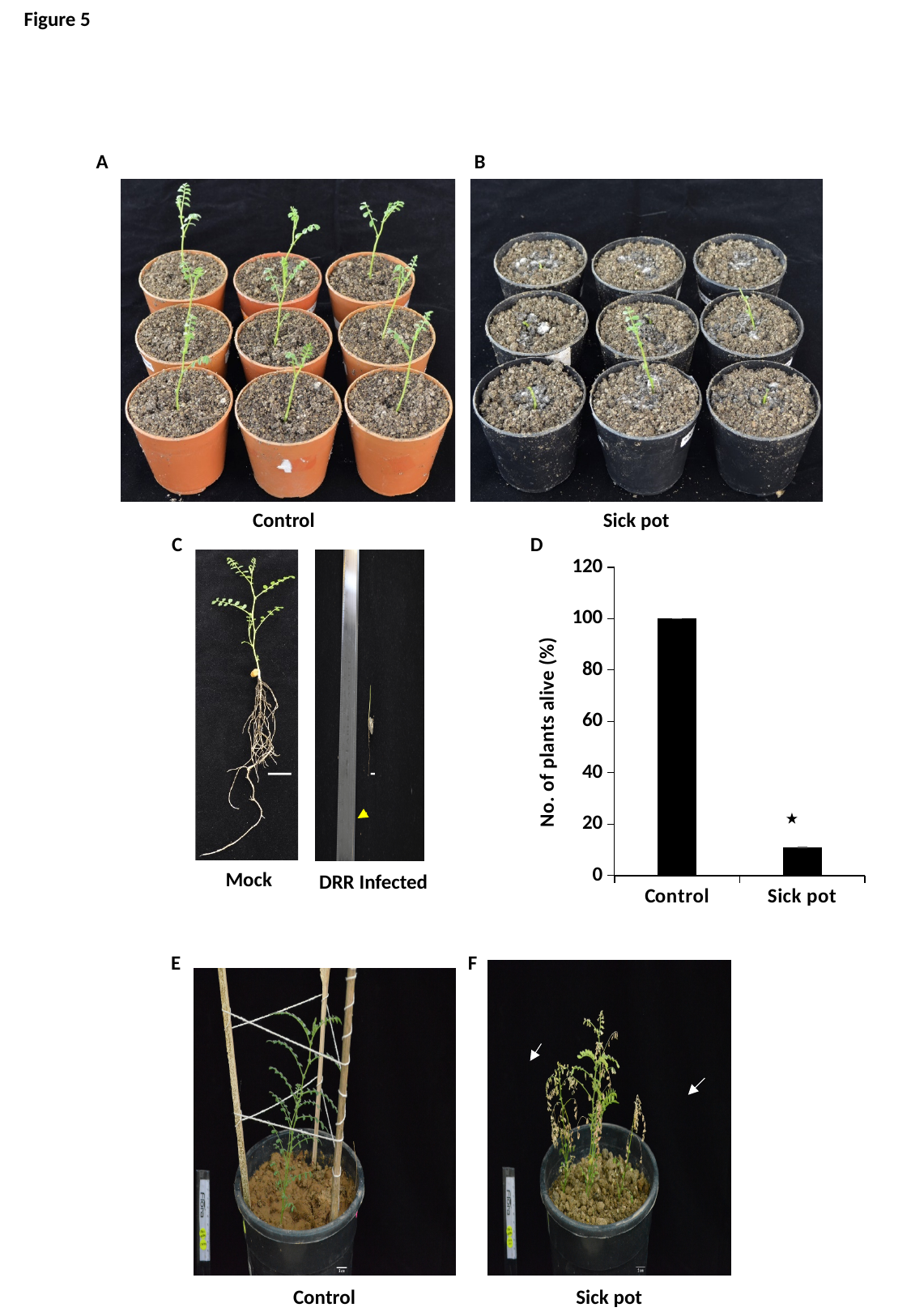
What is the y-axis label of the bar chart in panel D? No. of plants alive (%) In the bar chart in panel D, which category has the highest value? Control In the bar chart in panel D, is the value for Sick pot greater or less than 20? less What kind of chart is shown in panel D? bar chart In the bar chart in panel D, which category has the lowest value? Sick pot What is the maximum value shown on the y axis of the bar chart in panel D? 120 In the bar chart in panel D, do the values rise or fall from Control to Sick pot? fall In the bar chart in panel D, what is the value for Control? 100 In the bar chart in panel D, which is larger, the value for Control or the value for Sick pot? Control In the bar chart in panel D, is the value for Control greater or less than 80? greater How many categories are shown on the x axis of the bar chart in panel D? 2